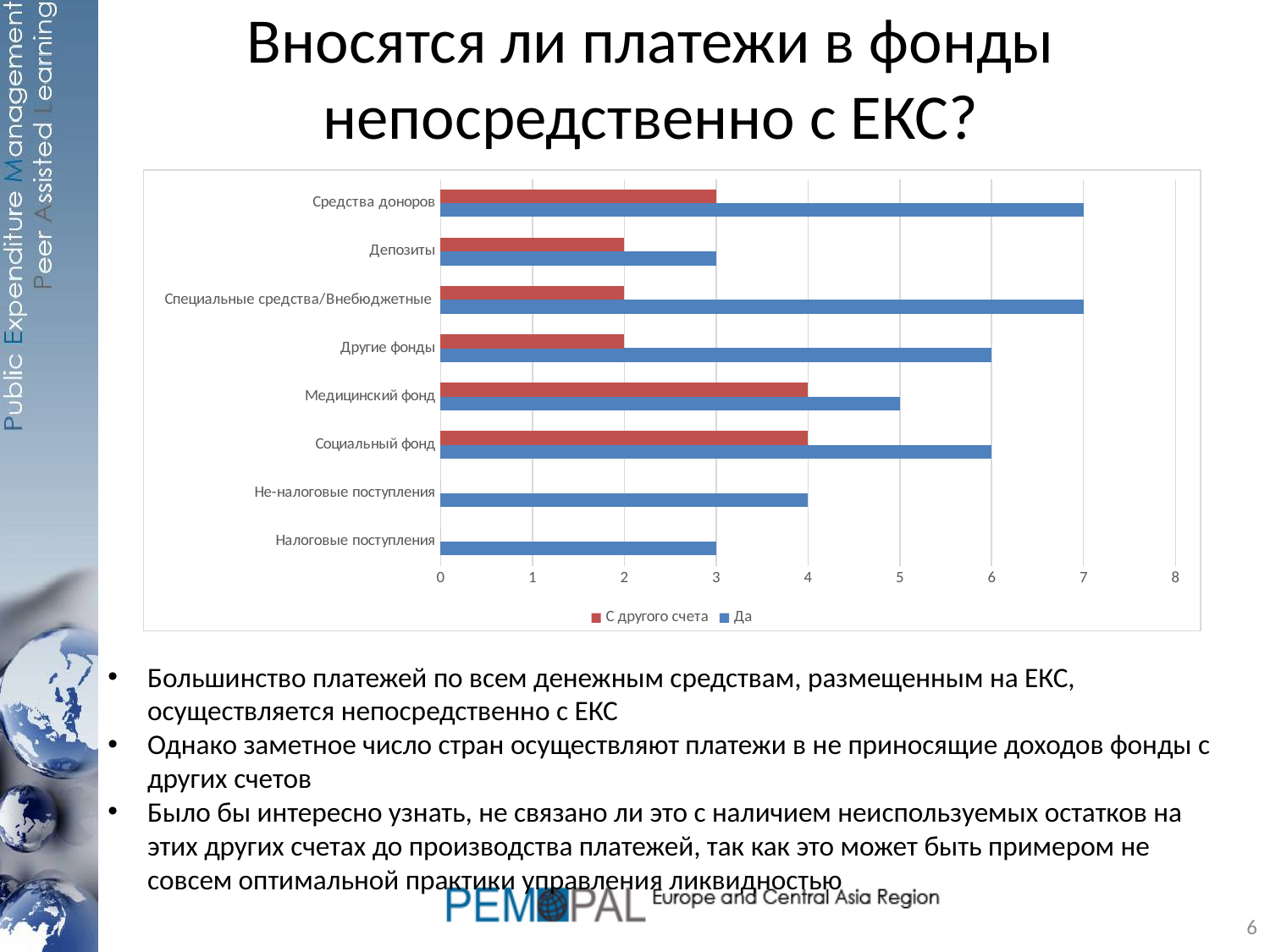
Which is larger: the "Да" value for Специальные средства/Внебюджетные or the "Да" value for Депозиты? Специальные средства/Внебюджетные How many categories are shown on the chart? 8 Is the "С другого счета" value for Социальный фонд greater or less than 3? greater What is the value of the "Да" series for Налоговые поступления? 3 What is the value of the "С другого счета" series for Депозиты? 2 What is the value of the "С другого счета" series for Медицинский фонд? 4 How many series does the legend list? 2 What is the difference between the "Да" and "С другого счета" values for Средства доноров? 4 Is the "Да" value for Другие фонды greater or less than 5? greater What colour represents the "Да" series in the chart? Blue What is the value of the "Да" series for Средства доноров? 7 What kind of chart is shown on the slide? Bar chart